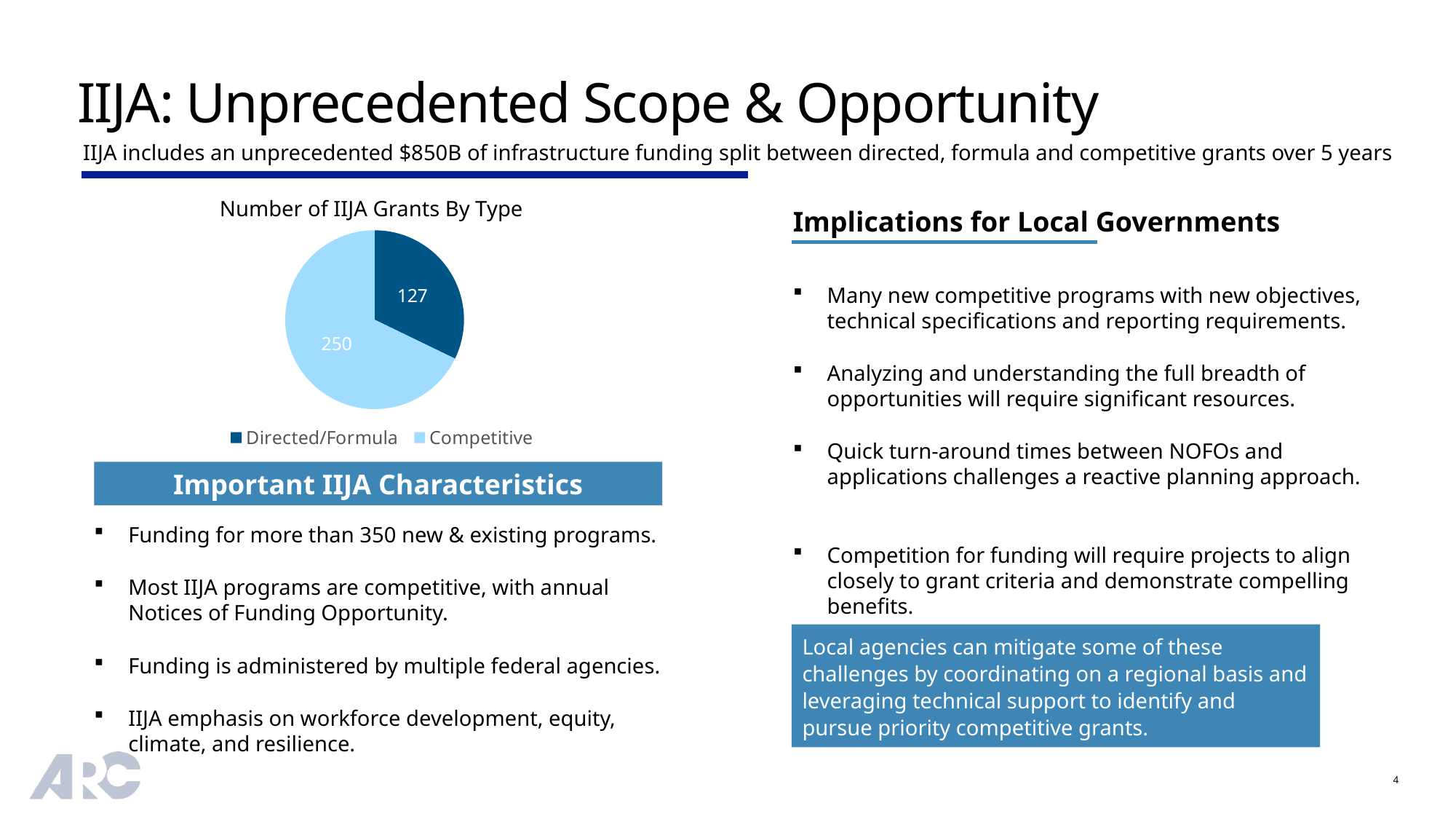
What is the title of the chart on the slide? Number of IIJA Grants By Type What is the total number of grants shown across both slices of the pie chart? 377 How many IIJA grants are Competitive according to the chart? 250 What is the difference between the number of Competitive grants and Directed/Formula grants? 123 How many slices does the pie chart have? 2 Which grant type has the smaller number of grants in the chart? Directed/Formula How many IIJA grants are Directed/Formula according to the chart? 127 How many entries does the chart legend list? 2 What type of chart is shown on the slide? Pie chart Is the number of Competitive grants greater or less than the number of Directed/Formula grants? greater Which grant type has the larger number of grants in the chart? Competitive Which colour represents Directed/Formula grants in the pie chart? Dark blue